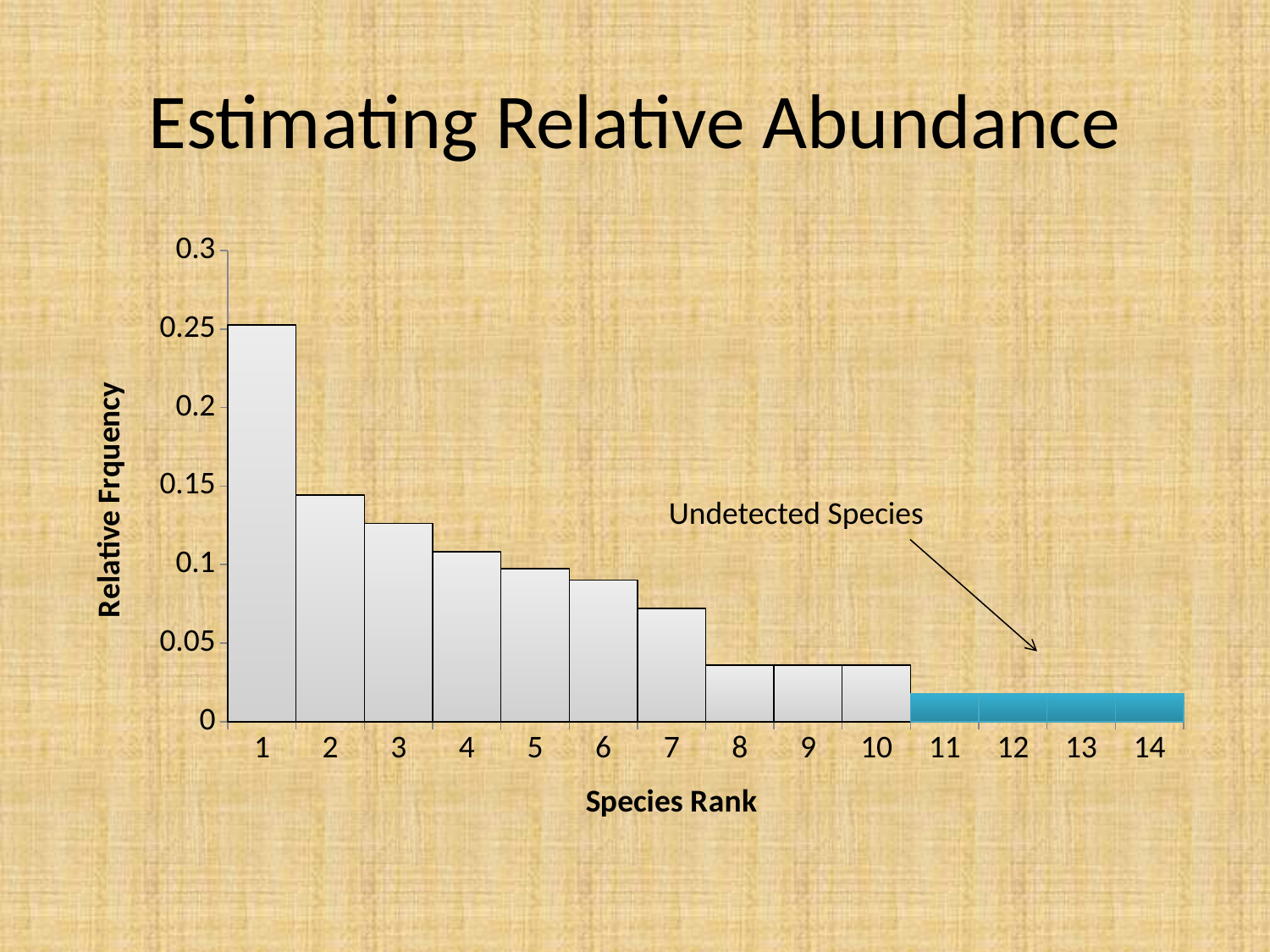
Is the relative frequency for species rank 1 greater or less than 0.2? greater Which has the larger relative frequency, species rank 3 or species rank 7? Species rank 3 Is the relative frequency for species rank 7 greater or less than 0.05? greater How many species ranks are plotted on the x axis? 14 What label does the arrow annotation on the chart give to the blue bars? Undetected Species Is the relative frequency for species rank 8 greater or less than 0.05? less Do the relative frequencies rise or fall as species rank increases? Fall What kind of chart is shown on the slide? Bar chart What is the title of the y axis of the chart? Relative Frquency Which species rank has the highest relative frequency? 1